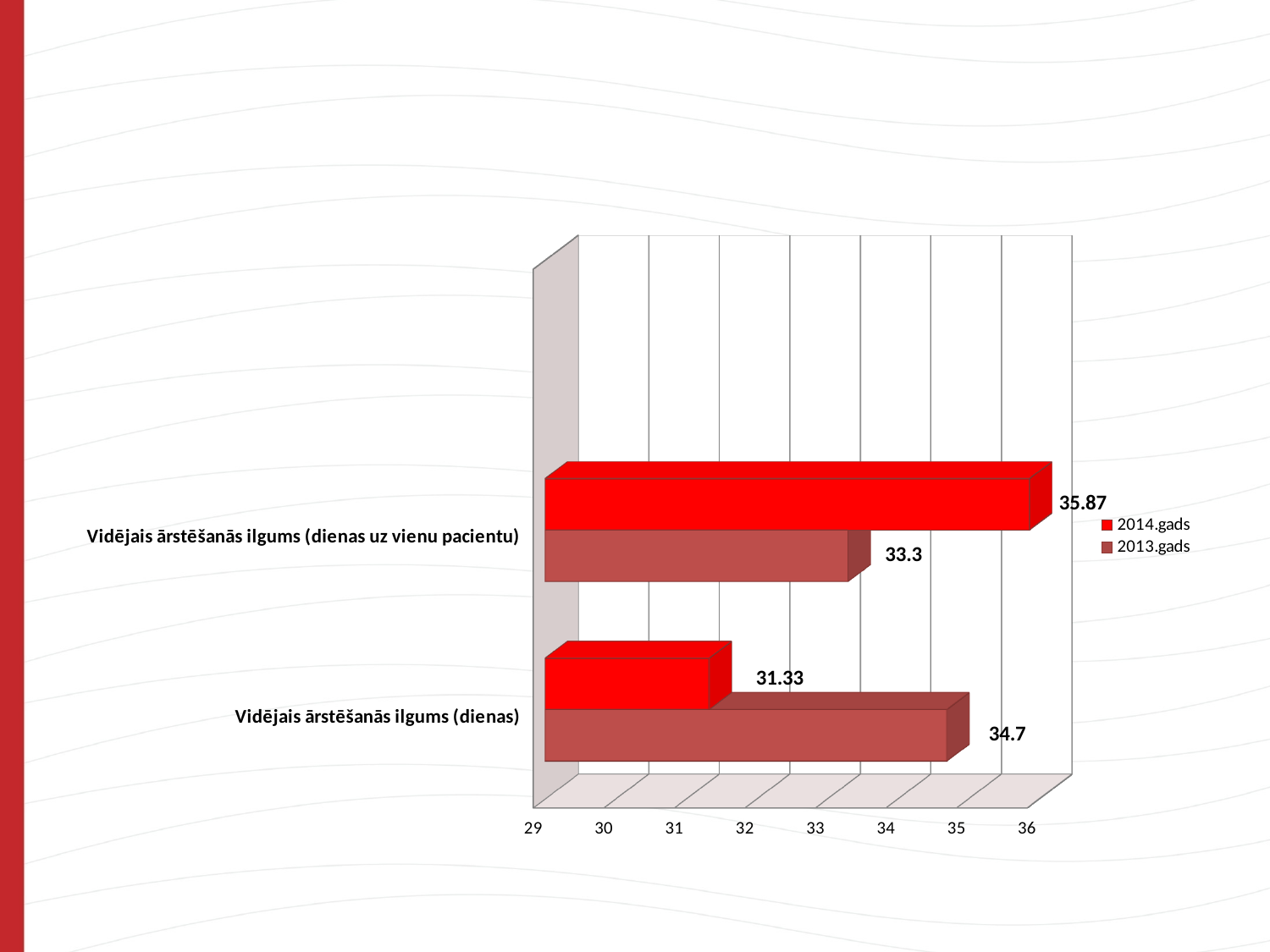
Which bar has the highest value in the chart? 2014.gads for Vidējais ārstēšanās ilgums (dienas uz vienu pacientu) Which bar has the lowest value in the chart? 2014.gads for Vidējais ārstēšanās ilgums (dienas) What kind of chart is shown on the slide? Bar chart What is the 2013.gads value for Vidējais ārstēšanās ilgums (dienas uz vienu pacientu)? 33.3 What is the 2014.gads value for Vidējais ārstēšanās ilgums (dienas)? 31.33 What is the 2013.gads value for Vidējais ārstēšanās ilgums (dienas)? 34.7 How many series does the legend list? 2 What is the difference between the 2014.gads and 2013.gads values for Vidējais ārstēšanās ilgums (dienas uz vienu pacientu)? 2.57 What is the 2014.gads value for Vidējais ārstēšanās ilgums (dienas uz vienu pacientu)? 35.87 Which series has the higher value for Vidējais ārstēšanās ilgums (dienas uz vienu pacientu)? 2014.gads Which series has the higher value for Vidējais ārstēšanās ilgums (dienas)? 2013.gads What is the difference between the 2013.gads and 2014.gads values for Vidējais ārstēšanās ilgums (dienas)? 3.37